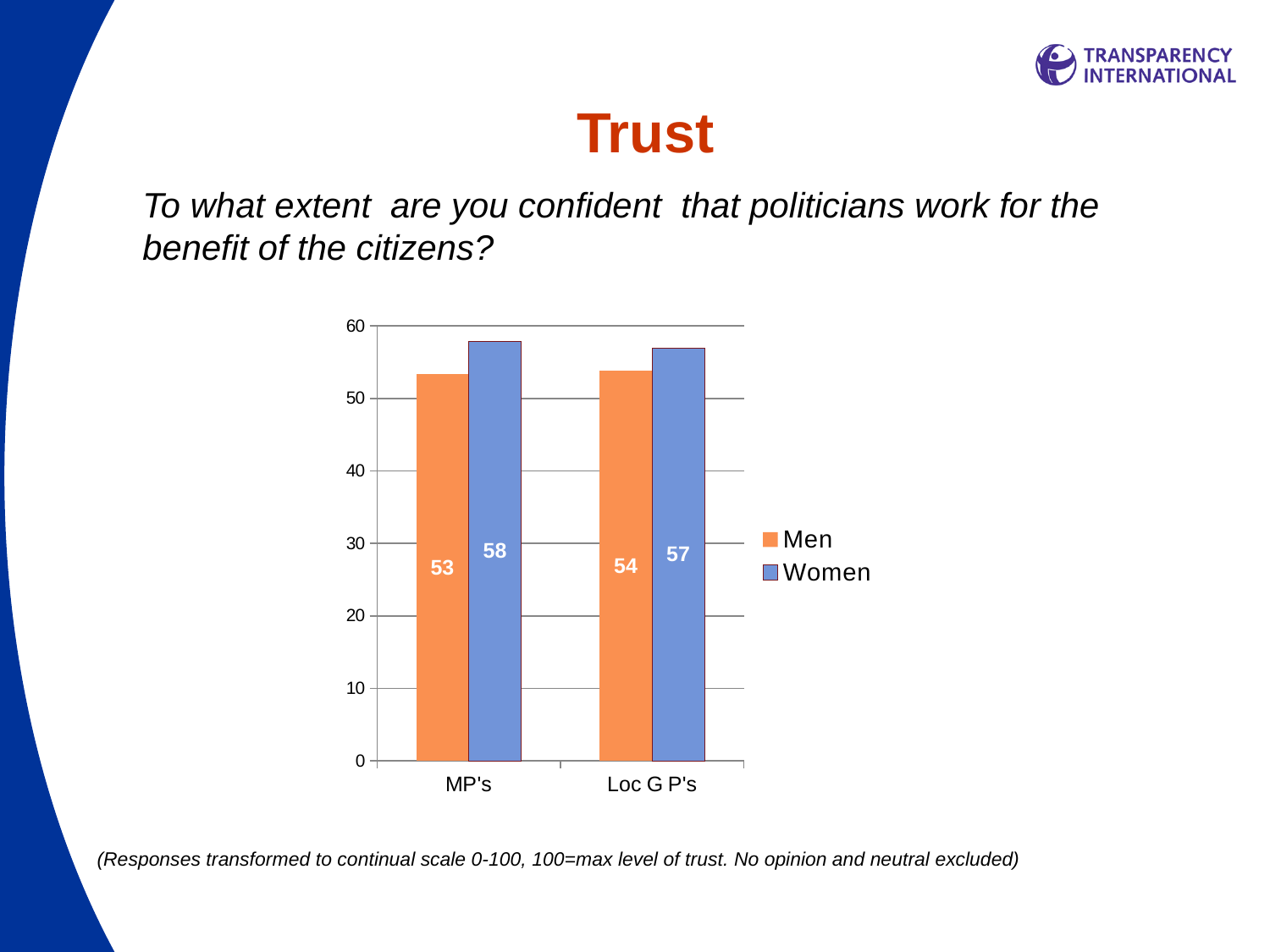
Which category has the highest Women value? MP's How many series does the legend list? 2 What is the value for Men for Loc G P's? 54 How many categories are shown on the x axis? 2 Which series has the higher value for MP's, Men or Women? Women Is the value for Men for MP's greater or less than 50? greater What is the value for Men for MP's? 53 What is the value for Women for MP's? 58 What is the difference between the Women and Men values for Loc G P's? 3 What is the difference between the Women and Men values for MP's? 5 What kind of chart is shown on the slide? bar chart What is the value for Women for Loc G P's? 57